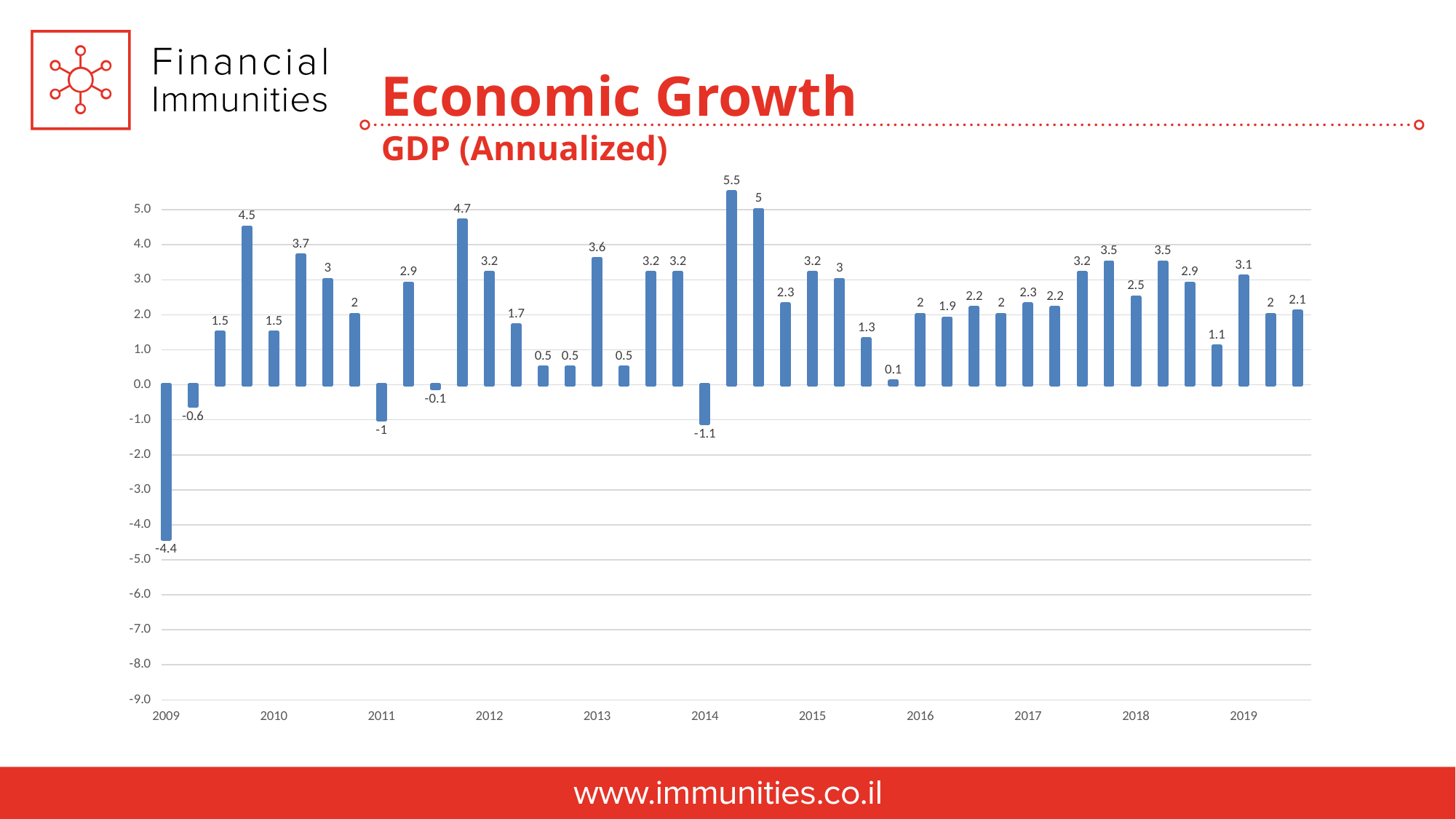
How many year labels appear on the x axis? 11 What is the value of the first bar at the 2019 label? 3.1 What is the highest value shown in the chart? 5.5 What is the lowest value shown in the chart? -4.4 Is the value of the first bar at the 2009 label greater or less than -4.0? less What is the value of the first bar labelled 2009? -4.4 What kind of chart is shown on the slide? bar chart What is the difference between the highest value (5.5) and the lowest value (-4.4) in the chart? 9.9 What is the value of the first bar at the 2014 label? -1.1 Which is larger: the first bar at the 2013 label (3.6) or the first bar at the 2012 label (3.2)? 2013 (3.6) What is the lowest value shown on the y axis? -9.0 What is the title of the chart? GDP (Annualized)